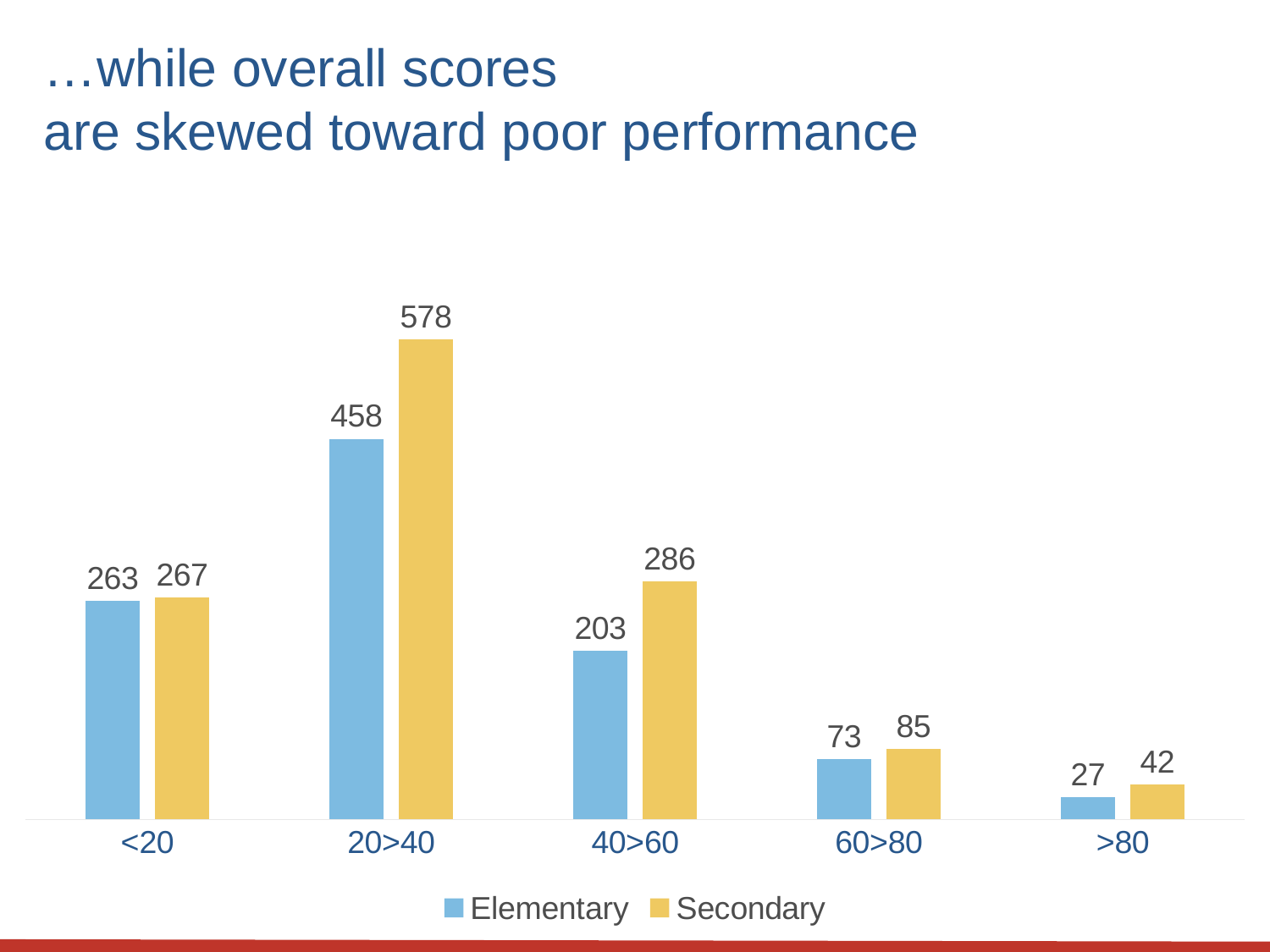
What is the difference between the Secondary and Elementary values for the 20>40 category? 120 How many categories are shown on the x axis? 5 What is the Secondary value for the 40>60 category? 286 Which category has the lowest Elementary value? >80 How many series does the legend list? 2 Do the Secondary values rise or fall from the 20>40 category to the >80 category? Fall Which colour represents the Secondary series? Yellow What kind of chart is shown on the slide? Bar chart Which category has the highest Secondary value? 20>40 What is the Elementary value for the >80 category? 27 Which is larger for the 60>80 category, Elementary or Secondary? Secondary What is the Elementary value for the 20>40 category? 458